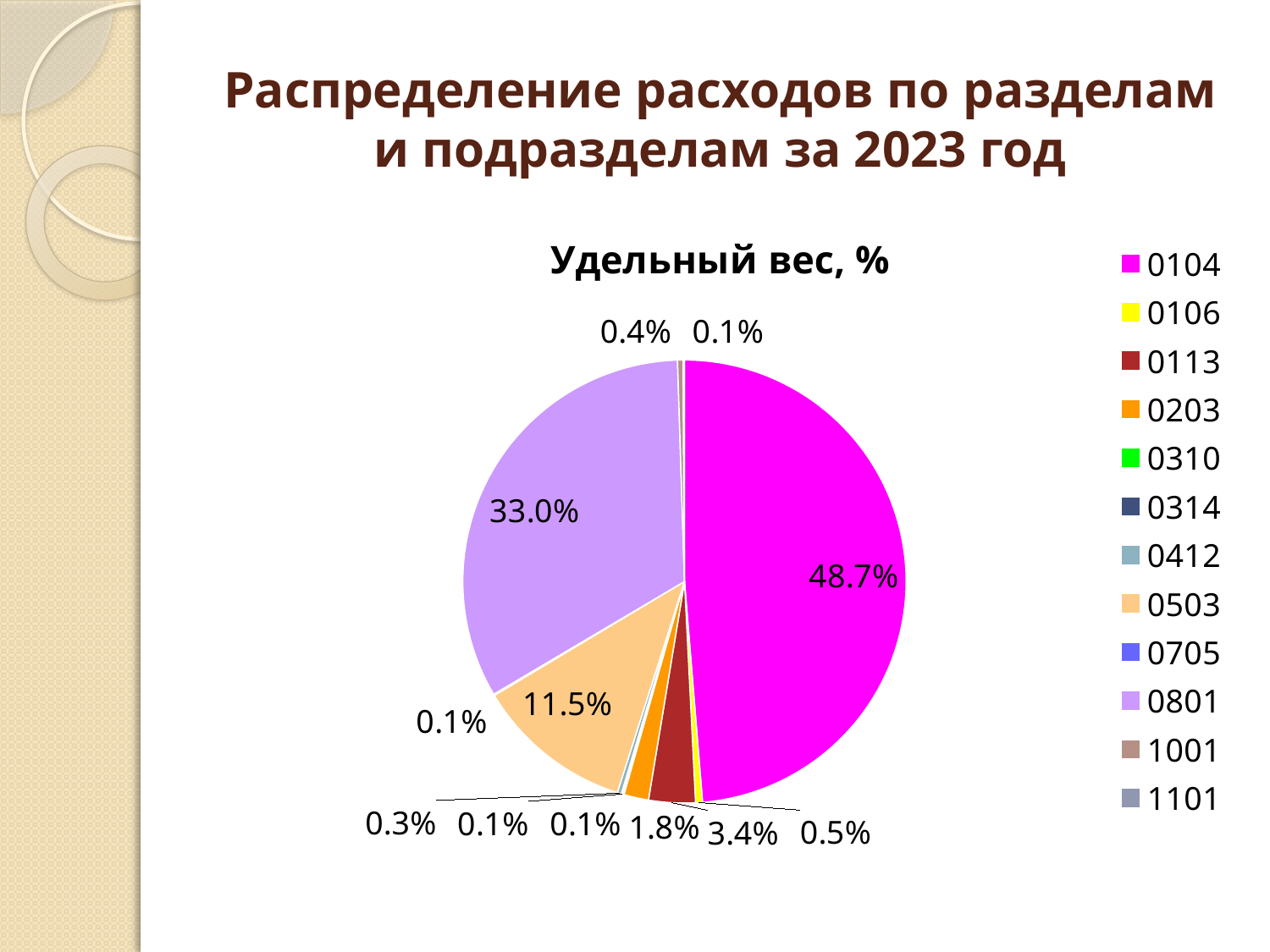
What kind of chart is shown on the slide? pie chart Which is larger, the share of category 0503 or the share of category 0113? 0503 What is the title of the chart? Удельный вес, % What is the value shown for category 0203? 1.8% What is the value shown for category 0113? 3.4% What is the value shown for category 0503? 11.5% How many categories does the legend of the pie chart list? 12 What share of the pie does category 0104 have? 48.7% What is the value shown for category 0801? 33.0% What colour is the slice for category 0104? magenta What is the difference in percentage points between category 0104 and category 0801? 15.7 Which category has the largest slice of the pie? 0104